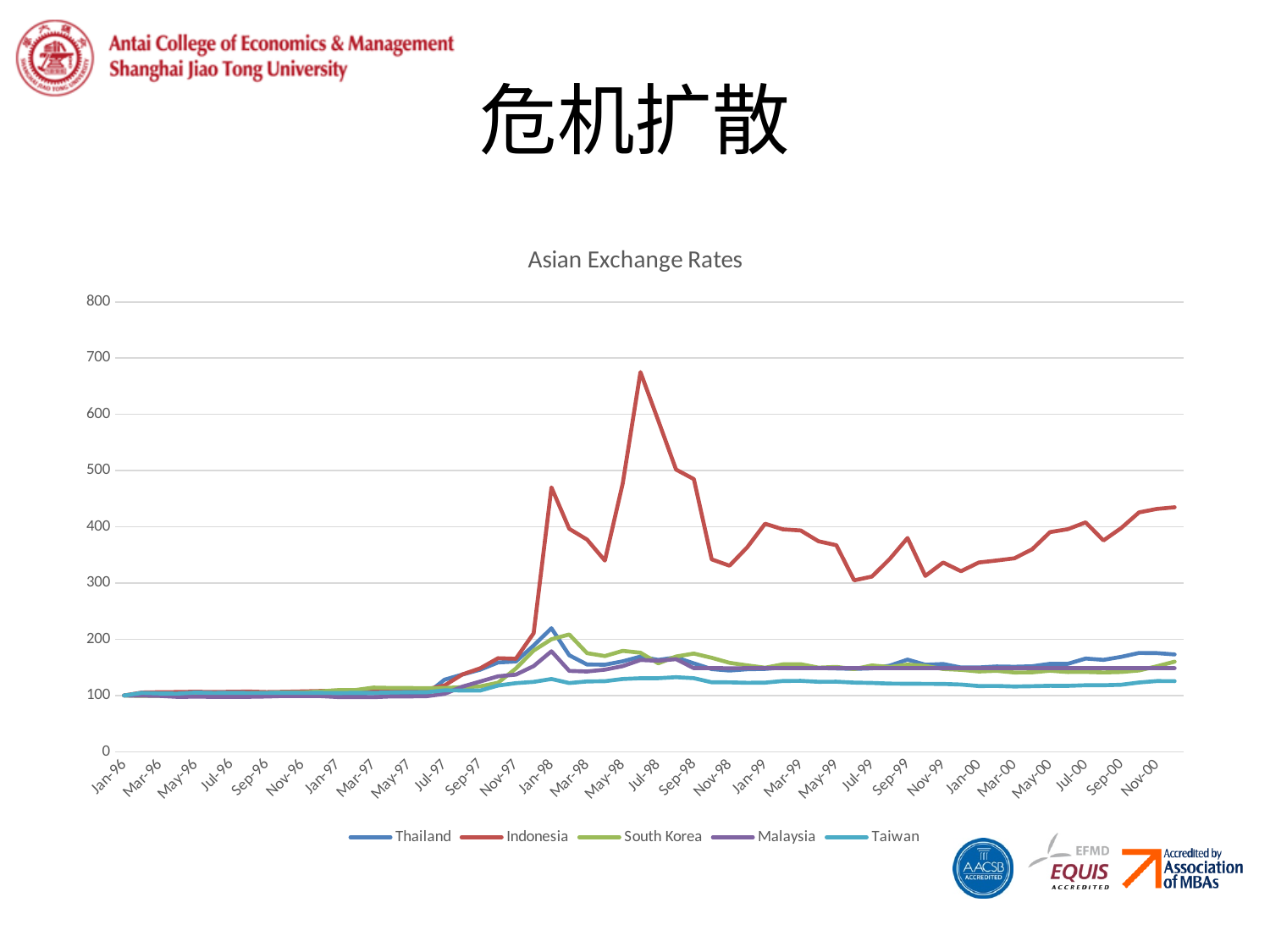
How many series does the legend list? 5 What kind of chart is shown on the slide? line chart Is the peak value for Indonesia around Jul-98 greater or less than 600? greater What is the title of the chart? Asian Exchange Rates Does the Indonesia series rise or fall from Jan-96 to Jul-98? rise At Nov-00, which is larger, the value for Thailand or the value for Taiwan? Thailand Which series reaches the highest value on the chart? Indonesia Is the value for Indonesia at Nov-00 greater or less than 400? greater At Jul-98, which is larger, the value for Indonesia or the value for South Korea? Indonesia Is the value for Taiwan at Nov-00 greater or less than 200? less What is the highest value shown on the vertical axis? 800 Which series has the lowest value at Nov-00? Taiwan